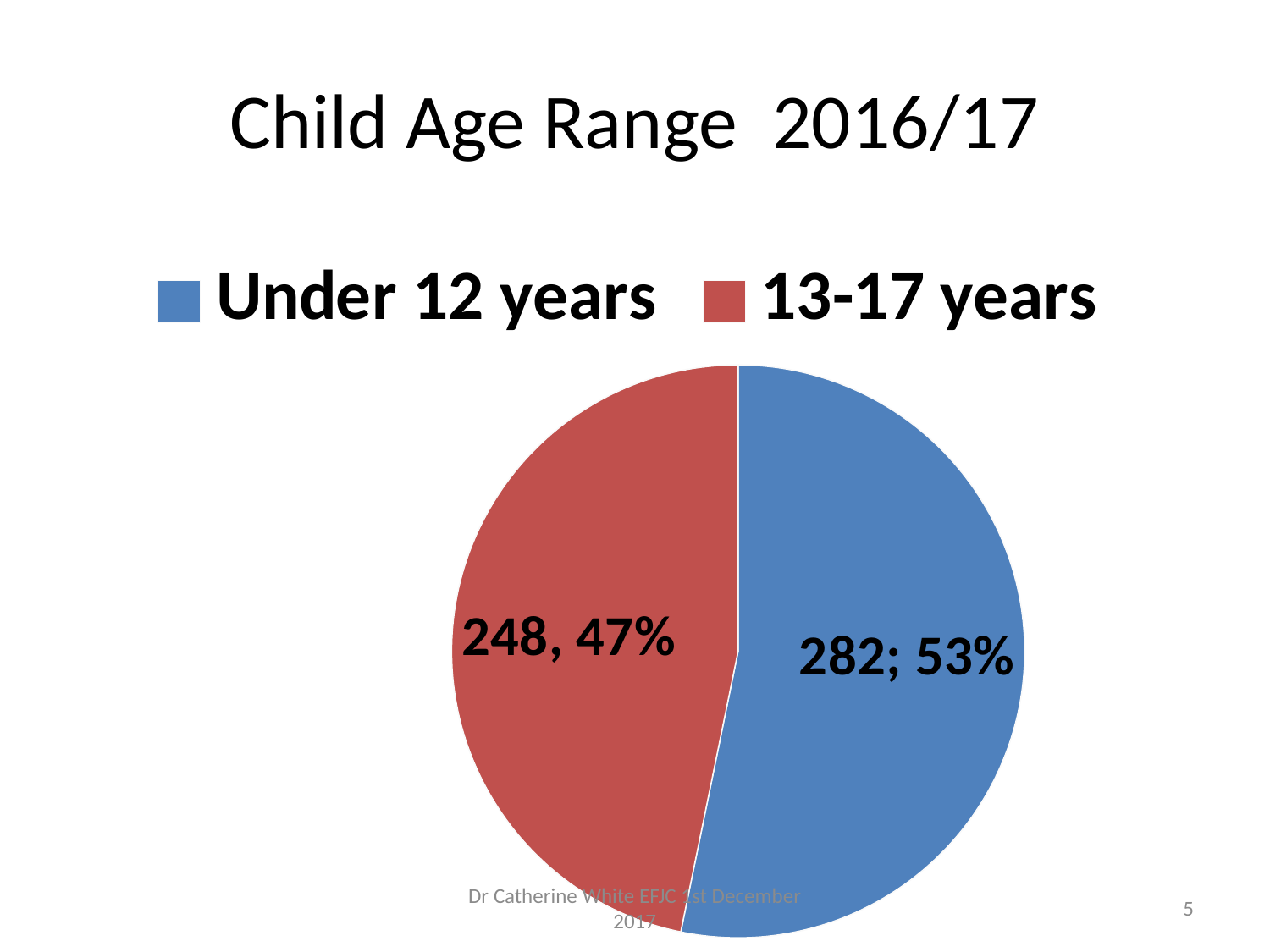
Which age group has the largest slice? Under 12 years What is the title of the chart? Child Age Range 2016/17 What type of chart is shown on the slide? pie chart What percentage share does the Under 12 years slice have? 53% What is the difference between the Under 12 years value and the 13-17 years value? 34 What is the value for 13-17 years? 248 What is the total of the two slice values? 530 What is the value for Under 12 years? 282 Which is larger, the value for Under 12 years or the value for 13-17 years? Under 12 years How many slices does the pie chart have? 2 What percentage share does the 13-17 years slice have? 47% Which age group has the smallest slice? 13-17 years